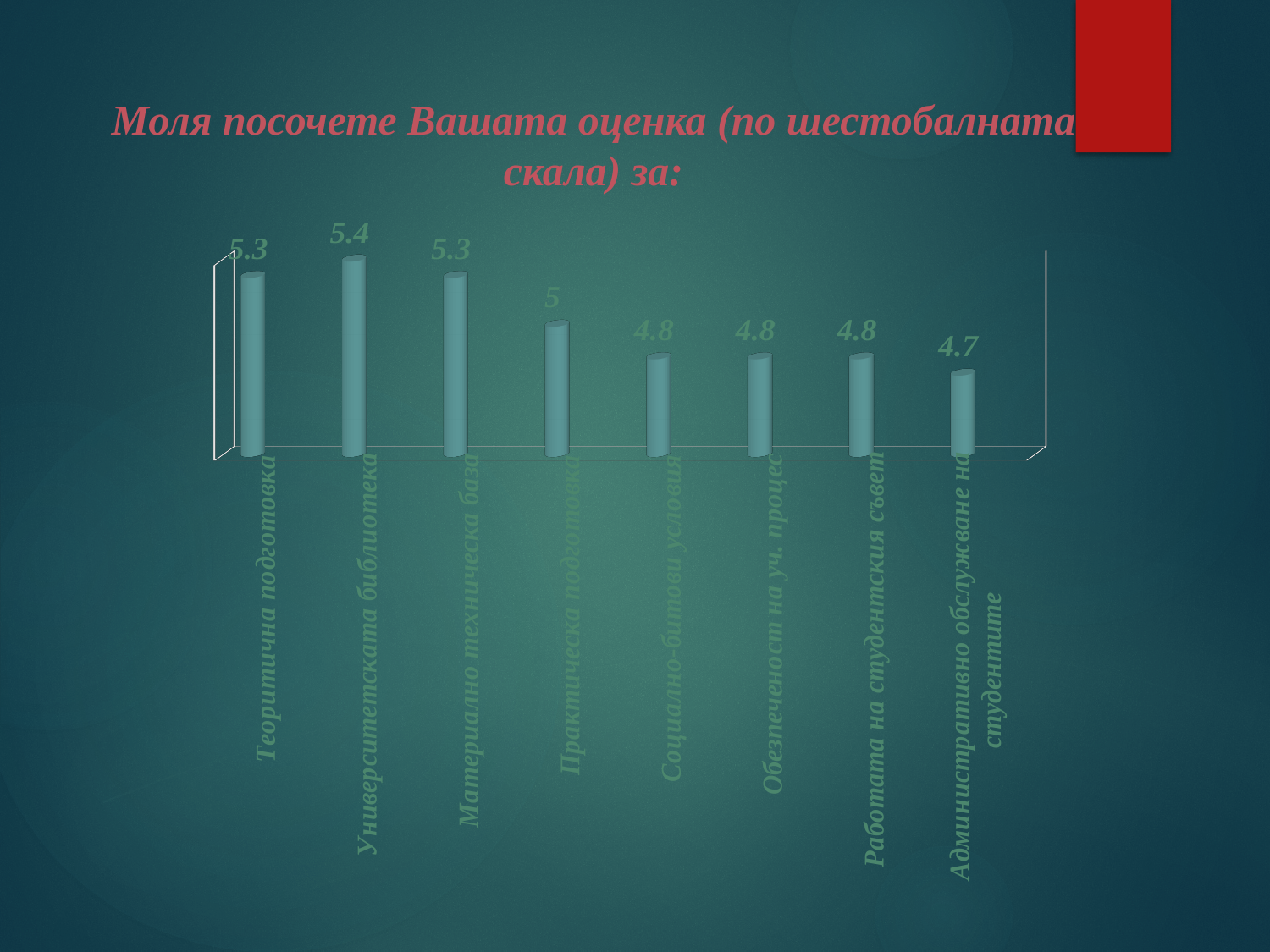
Do the values generally rise or fall from left to right across the categories? Fall What value is shown for Социално-битови условия? 4.8 Which is larger, the value for Материално техническа база or the value for Обезпеченост на уч. процес? Материално техническа база What kind of chart is shown on the slide? Bar chart Which category has the highest value? Университетската библиотека What value is shown for Практическа подготовка? 5 What is the difference between the values for Теоритична подготовка and Практическа подготовка? 0.3 How many categories are shown in the chart? 8 What value is shown for Университетската библиотека? 5.4 What is the difference between the values for Университетската библиотека and Административно обслужване на студентите? 0.7 What value is shown for Административно обслужване на студентите? 4.7 Which category has the lowest value? Административно обслужване на студентите